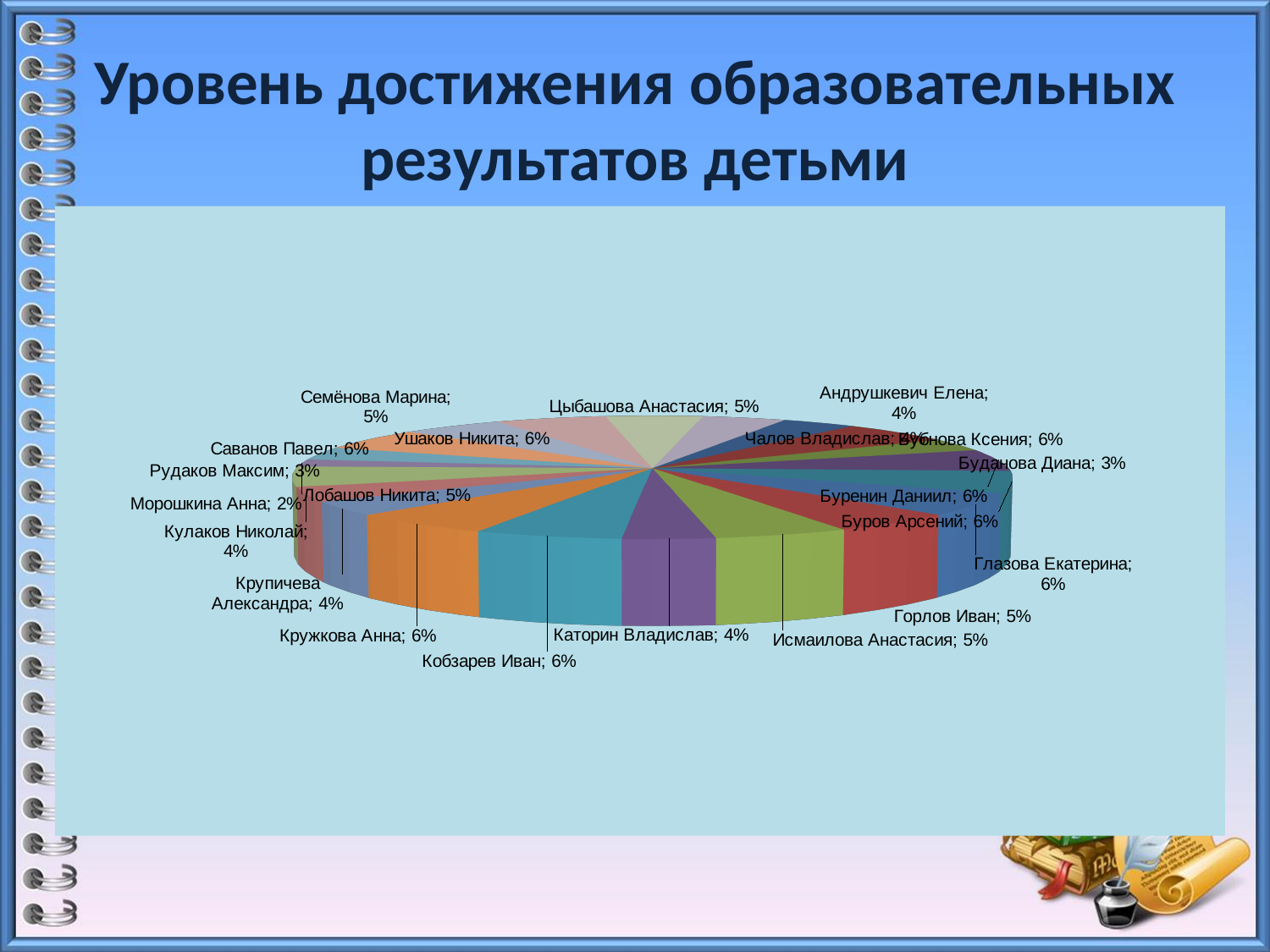
What is the difference in percentage points between Глазова Екатерина and Буданова Диана? 3 What percentage is shown for Морошкина Анна? 2% What percentage is shown for Андрушкевич Елена? 4% What percentage is shown for Буданова Диана? 3% What type of chart is shown on the slide? pie chart What percentage is shown for Горлов Иван? 5% What is the title of the slide containing the chart? Уровень достижения образовательных результатов детьми What percentage is shown for Рудаков Максим? 3% What percentage is shown for Кобзарев Иван? 6% What is the difference in percentage points between Ушаков Никита and Кулаков Николай? 2 Which has a larger share, Семёнова Марина or Морошкина Анна? Семёнова Марина Which has a larger share, Кружкова Анна or Каторин Владислав? Кружкова Анна